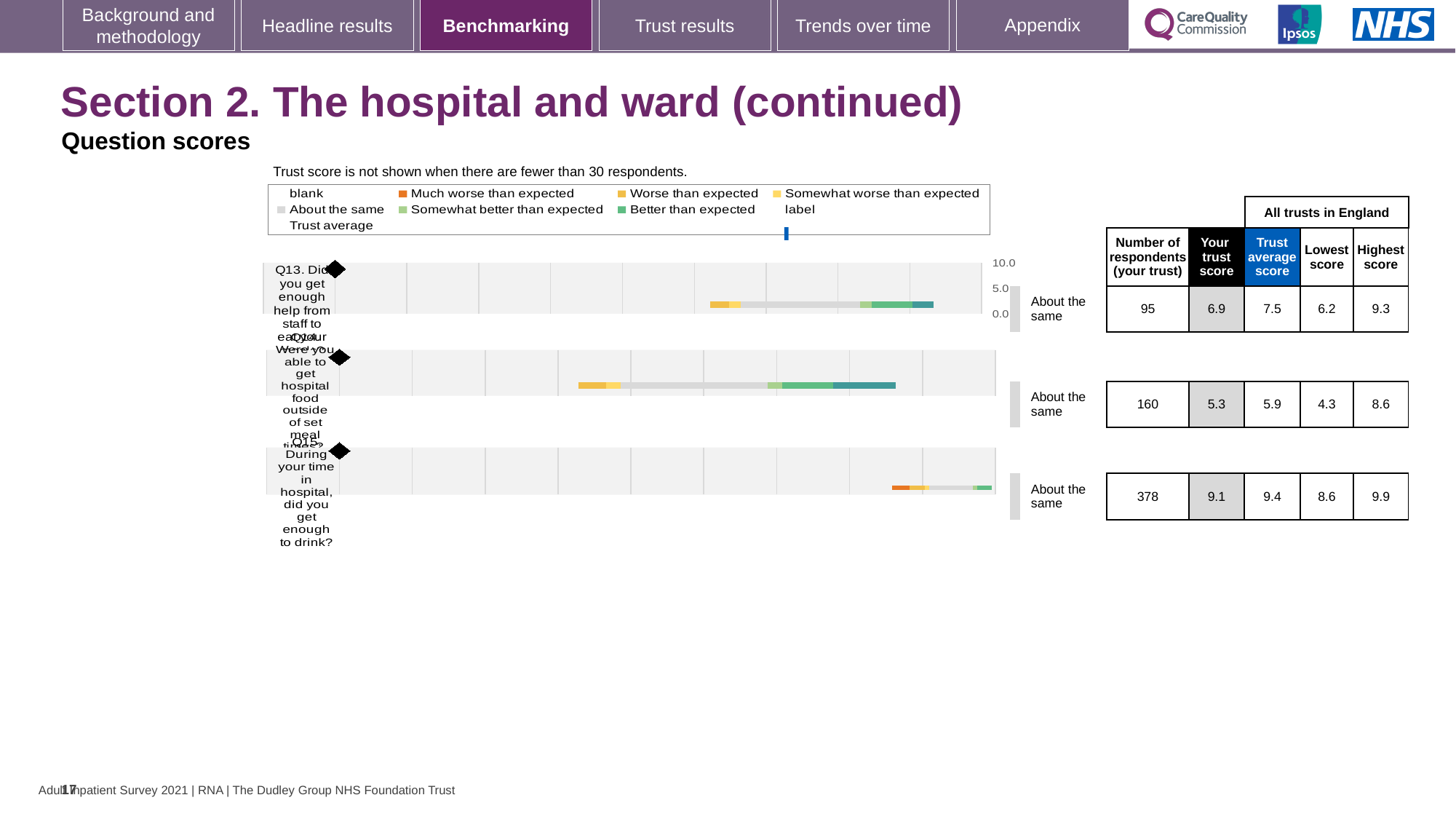
What kind of chart is used to show the question scores on this slide? Bar chart Which question has the highest 'Your trust score' on this slide? Q15 What is the highest score across all trusts in England for Q14? 8.6 What is the lowest score across all trusts in England for Q13? 6.2 For Q13, which is larger: your trust score or the trust average score? Trust average score Which question has the lowest 'Your trust score' on this slide? Q14 How many respondents answered Q14 (Were you able to get hospital food outside of set meal times?) at this trust? 160 For Q14, what is the difference between the trust average score (5.9) and your trust score (5.3)? 0.6 Is the trust score for Q15 greater or less than 5.0? greater What is the trust average score for Q15 (did you get enough to drink?)? 9.4 What is the 'Your trust score' for Q13 (Did you get enough help from staff to eat your meals?)? 6.9 How many questions are plotted in the chart on this slide? 3